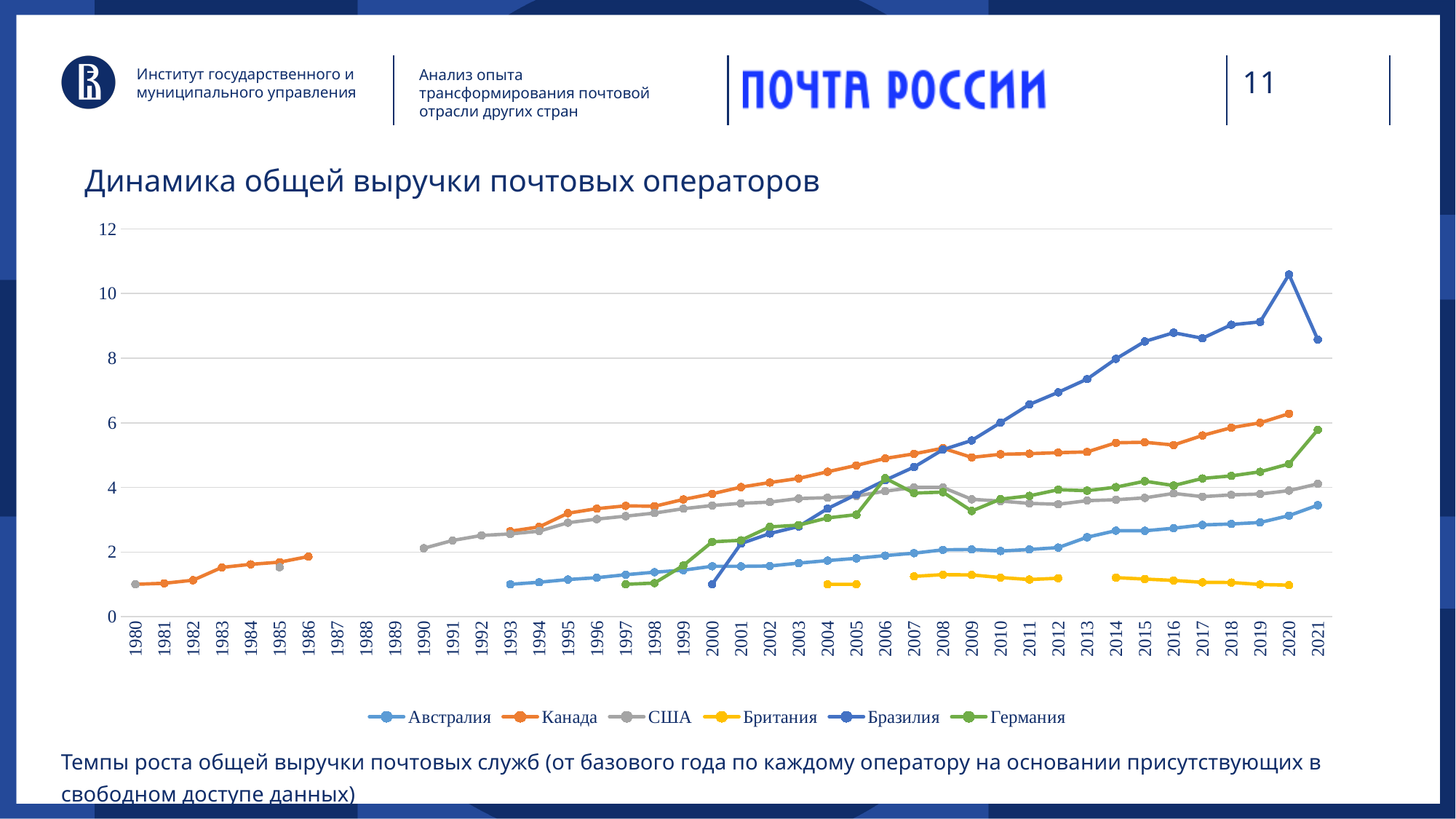
Is the value for Бразилия in 2015 greater or less than 8? greater What is the title of the chart? Динамика общей выручки почтовых операторов Which series reaches the highest value on the chart? Бразилия Does the value for Бразилия rise or fall from 2000 to 2020? rise Which is larger in 2020, the value for Бразилия or the value for Канада? Бразилия Is the value for Австралия in 2021 greater or less than 4? less Which series has the lowest value in 2019? Британия What kind of chart is shown on the slide? Line chart Is the value for Бразилия in 2020 greater or less than 10? greater How many series does the legend list? 6